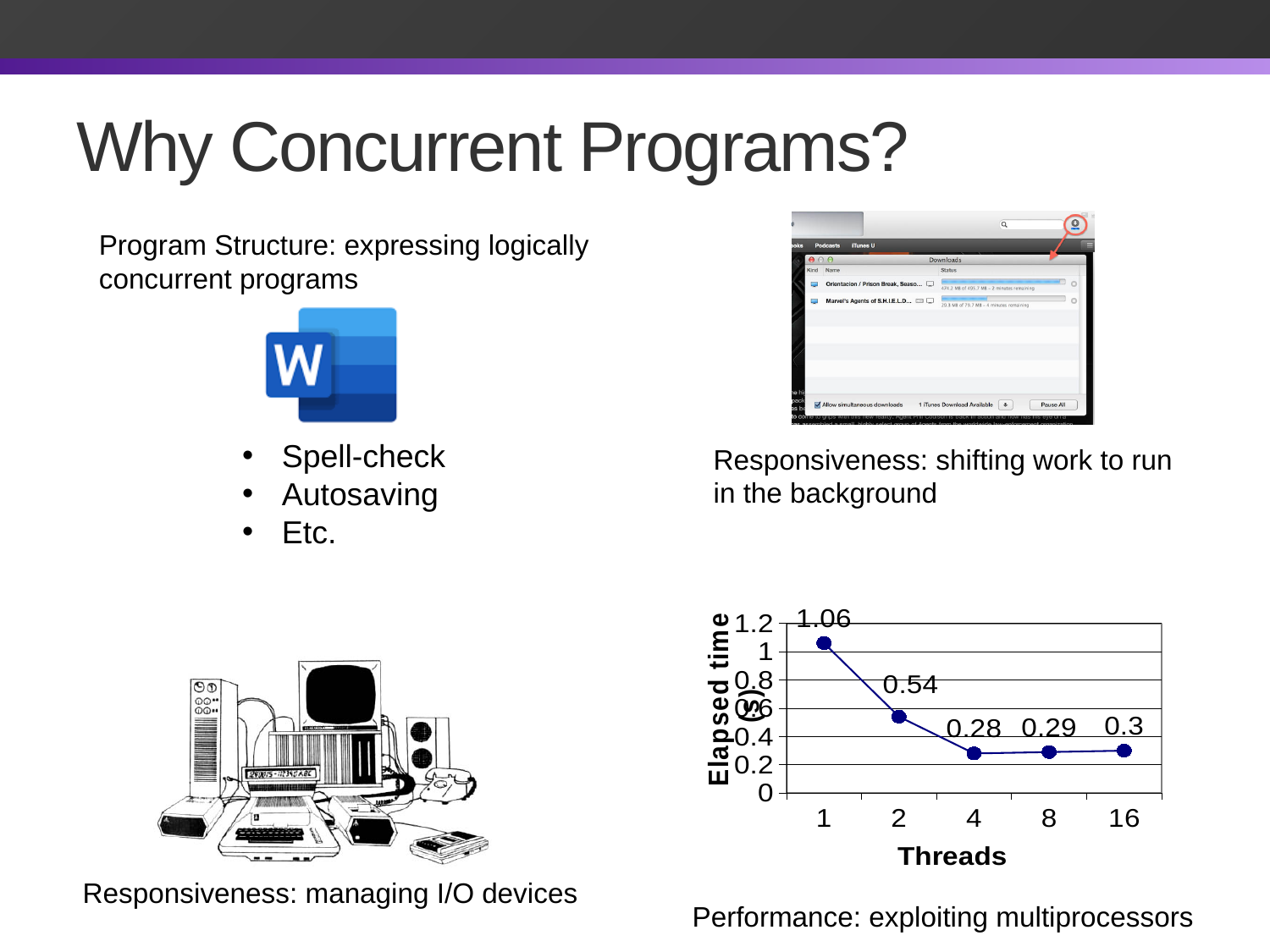
Which has a larger elapsed time, 2 threads or 8 threads? 2 threads Which thread count has the highest elapsed time? 1 How many thread counts are plotted on the x axis? 5 What is the difference in elapsed time between 1 thread and 2 threads? 0.52 What is the elapsed time for 2 threads? 0.54 What is the label of the y axis of the chart? Elapsed time (s) What is the elapsed time for 16 threads? 0.3 Which thread count has the lowest elapsed time? 4 What is the elapsed time for 4 threads? 0.28 Does the elapsed time rise or fall from 1 thread to 4 threads? fall What kind of chart is shown on the slide? line chart What is the elapsed time for 1 thread? 1.06